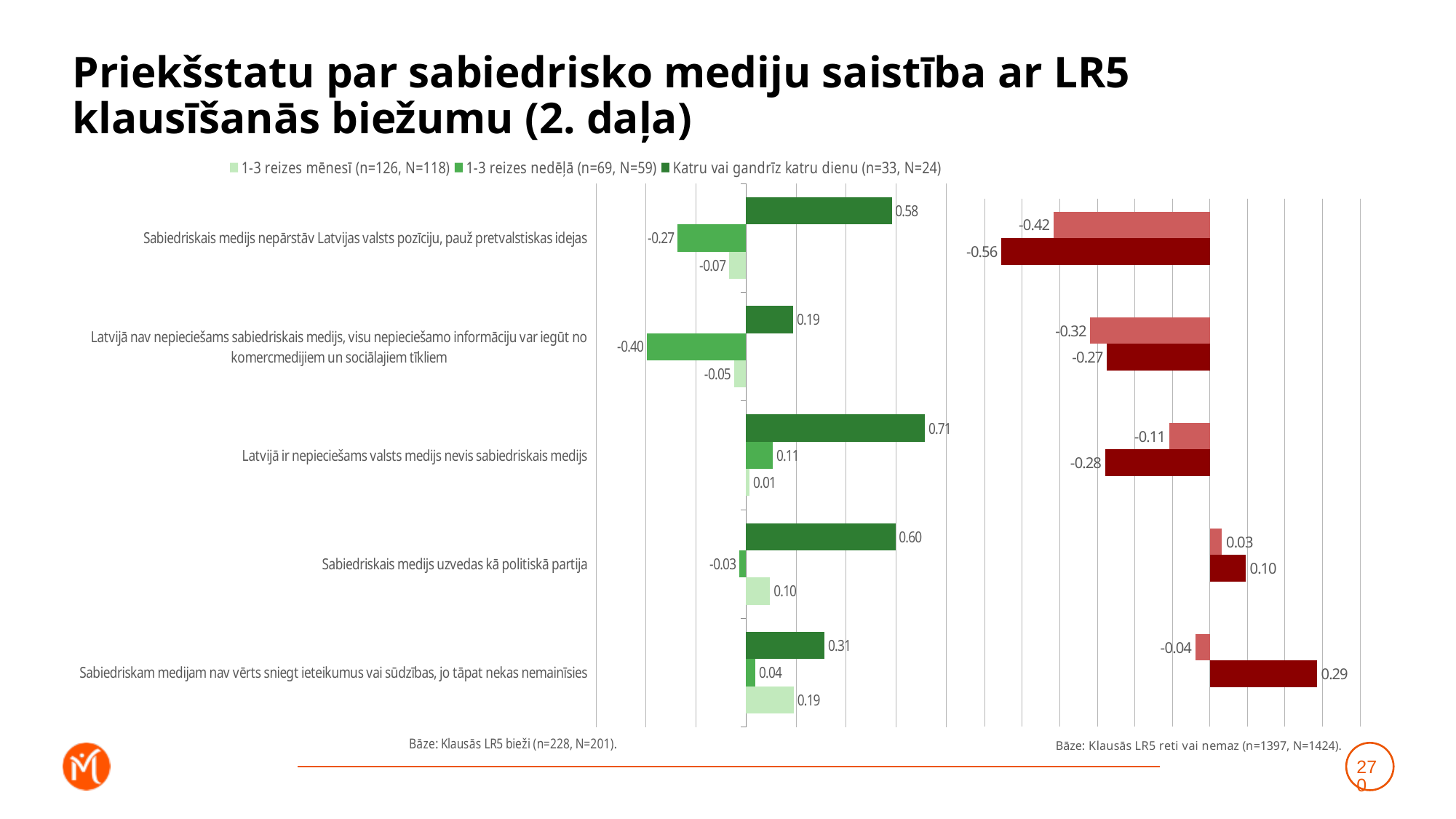
In the left chart (Bāze: Klausās LR5 bieži), what is the value for '1-3 reizes mēnesī' for the statement 'Sabiedriskam medijam nav vērts sniegt ieteikumus vai sūdzības, jo tāpat nekas nemainīsies'? 0.19 In the right chart (Bāze: Klausās LR5 reti vai nemaz), what is the value of the dark red bar for the statement 'Sabiedriskais medijs nepārstāv Latvijas valsts pozīciju, pauž pretvalstiskas idejas'? -0.56 In the left chart (Bāze: Klausās LR5 bieži), for the statement 'Sabiedriskais medijs nepārstāv Latvijas valsts pozīciju, pauž pretvalstiskas idejas', which is larger: the value for '1-3 reizes nedēļā' or for '1-3 reizes mēnesī'? 1-3 reizes mēnesī How many series does the legend of the left chart (Bāze: Klausās LR5 bieži) list? 3 How many statements (categories) are shown in the left chart (Bāze: Klausās LR5 bieži)? 5 In the left chart (Bāze: Klausās LR5 bieži), which statement has the highest value for 'Katru vai gandrīz katru dienu'? Latvijā ir nepieciešams valsts medijs nevis sabiedriskais medijs In the left chart (Bāze: Klausās LR5 bieži), what is the value for '1-3 reizes nedēļā' for the statement 'Latvijā nav nepieciešams sabiedriskais medijs, visu nepieciešamo informāciju var iegūt no komercmedijiem un sociālajiem tīkliem'? -0.40 In the left chart (Bāze: Klausās LR5 bieži), what is the value for 'Katru vai gandrīz katru dienu' for the statement 'Latvijā ir nepieciešams valsts medijs nevis sabiedriskais medijs'? 0.71 In the right chart (Bāze: Klausās LR5 reti vai nemaz), what is the value of the dark red bar for the statement 'Sabiedriskam medijam nav vērts sniegt ieteikumus vai sūdzības, jo tāpat nekas nemainīsies'? 0.29 What kind of chart is the left chart (Bāze: Klausās LR5 bieži)? Bar chart In the left chart (Bāze: Klausās LR5 bieži), what is the difference between the 'Katru vai gandrīz katru dienu' values for 'Sabiedriskais medijs uzvedas kā politiskā partija' and 'Sabiedriskam medijam nav vērts sniegt ieteikumus vai sūdzības, jo tāpat nekas nemainīsies'? 0.29 In the left chart (Bāze: Klausās LR5 bieži), which statement has the lowest value for 'Katru vai gandrīz katru dienu'? Latvijā nav nepieciešams sabiedriskais medijs, visu nepieciešamo informāciju var iegūt no komercmedijiem un sociālajiem tīkliem